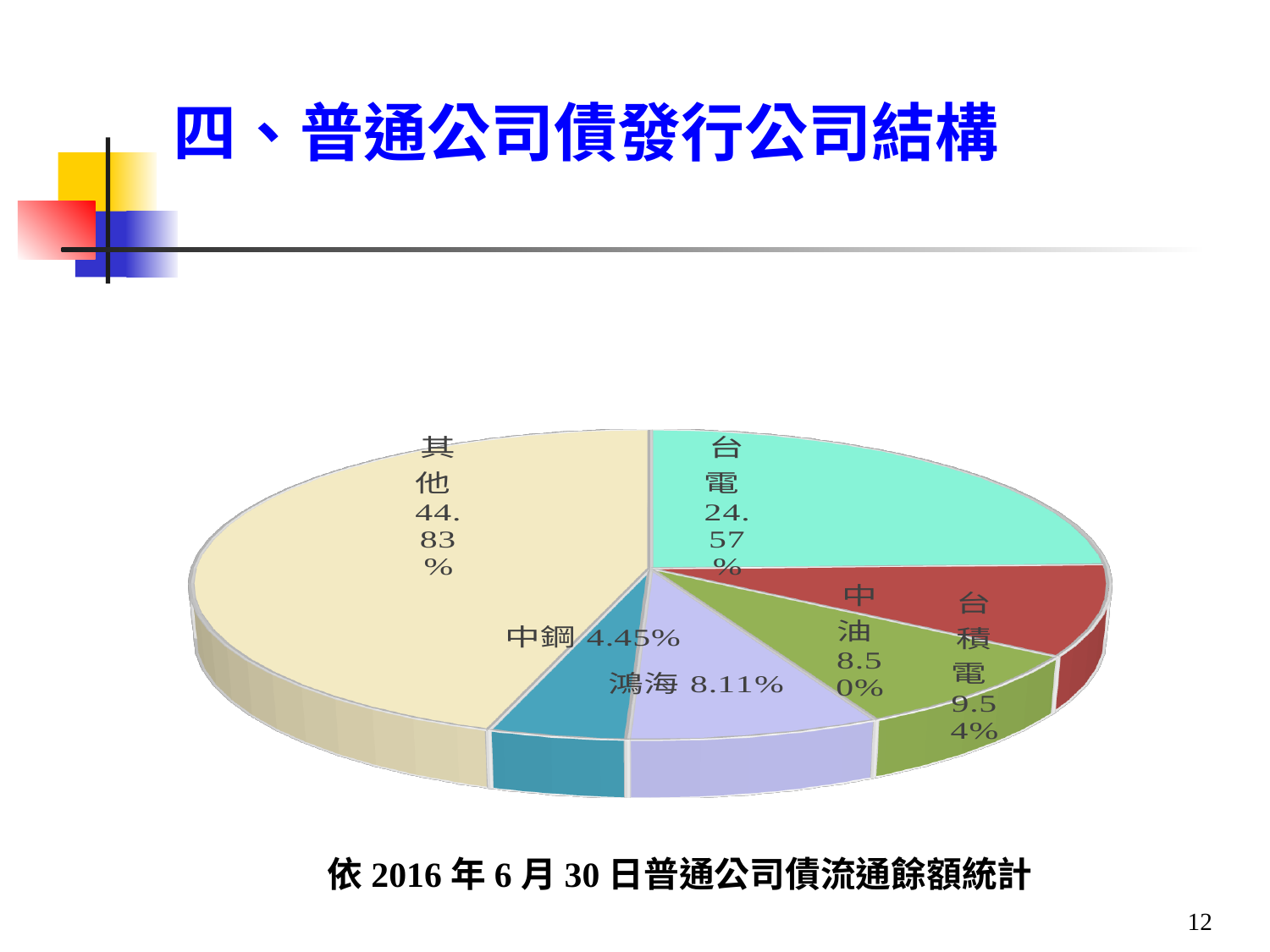
Which is larger, the 台積電 slice or the 鴻海 slice? 台積電 Which slice of the pie is the largest? 其他 What is the difference in percentage points between the 其他 slice and the 台電 slice? 20.26 What kind of chart is shown on the slide? Pie chart What share of the pie does 台積電 hold? 9.54% What share of the pie does 鴻海 hold? 8.11% What share of the pie does 其他 hold? 44.83% How many slices does the pie chart have? 6 What share of the pie does 中油 hold? 8.50% What share of the pie does 中鋼 hold? 4.45% Which slice of the pie is the smallest? 中鋼 What share of the pie does 台電 hold? 24.57%